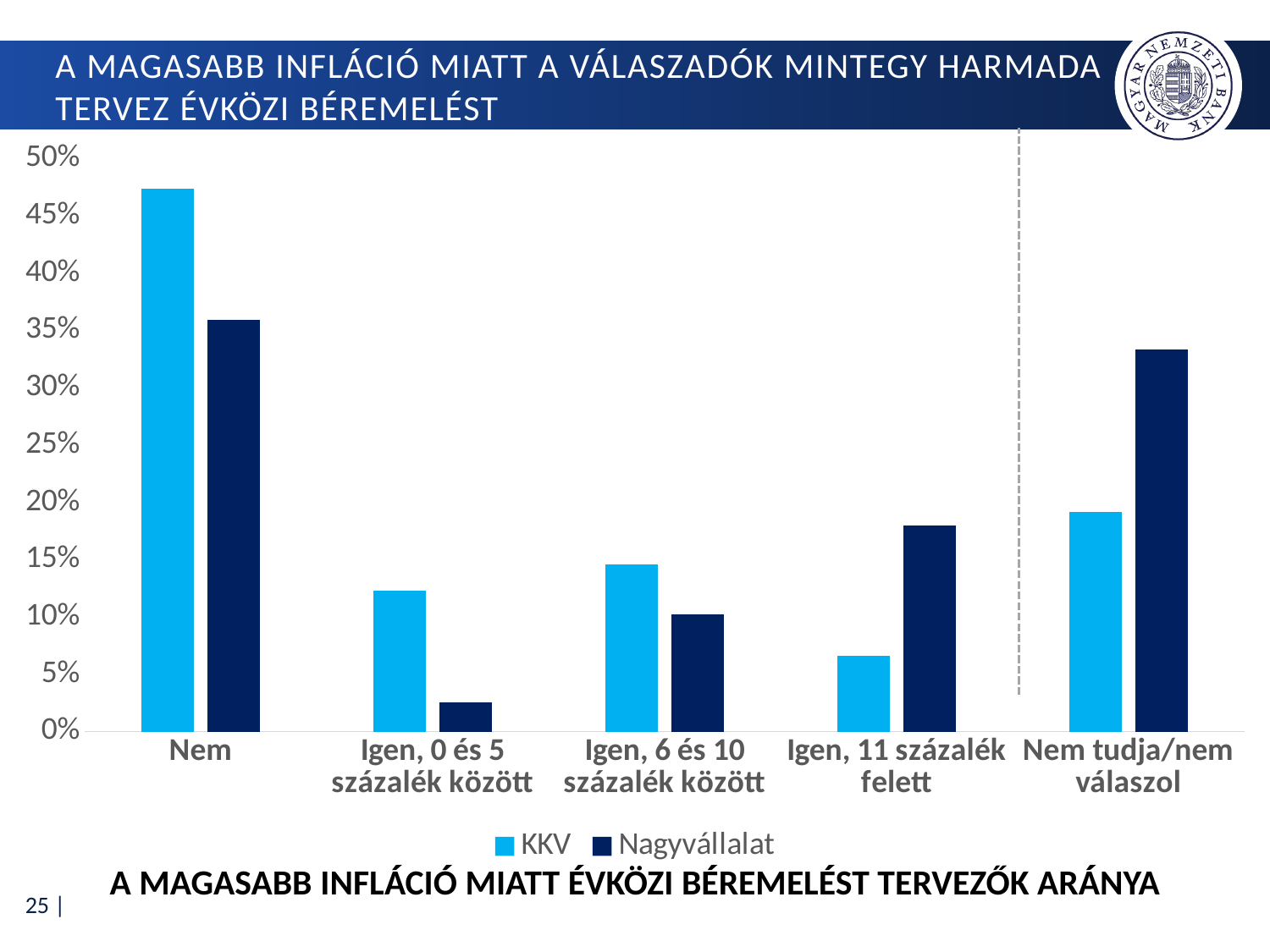
Is the Nagyvállalat value for Nem tudja/nem válaszol greater or less than 30%? greater What are the two legend entries of the chart? KKV and Nagyvállalat What kind of chart is shown on the slide? bar chart Is the KKV value for Nem greater or less than 45%? greater Which category has the lowest value for the Nagyvállalat series? Igen, 0 és 5 százalék között Which category has the lowest value for the KKV series? Igen, 11 százalék felett Is the Nagyvállalat value for Igen, 0 és 5 százalék között greater or less than 5%? less Which category has the highest value for the KKV series? Nem How many series does the legend list? 2 For Igen, 11 százalék felett, which series has the larger value, KKV or Nagyvállalat? Nagyvállalat For Igen, 6 és 10 százalék között, which series has the larger value, KKV or Nagyvállalat? KKV How many categories are shown on the x axis? 5